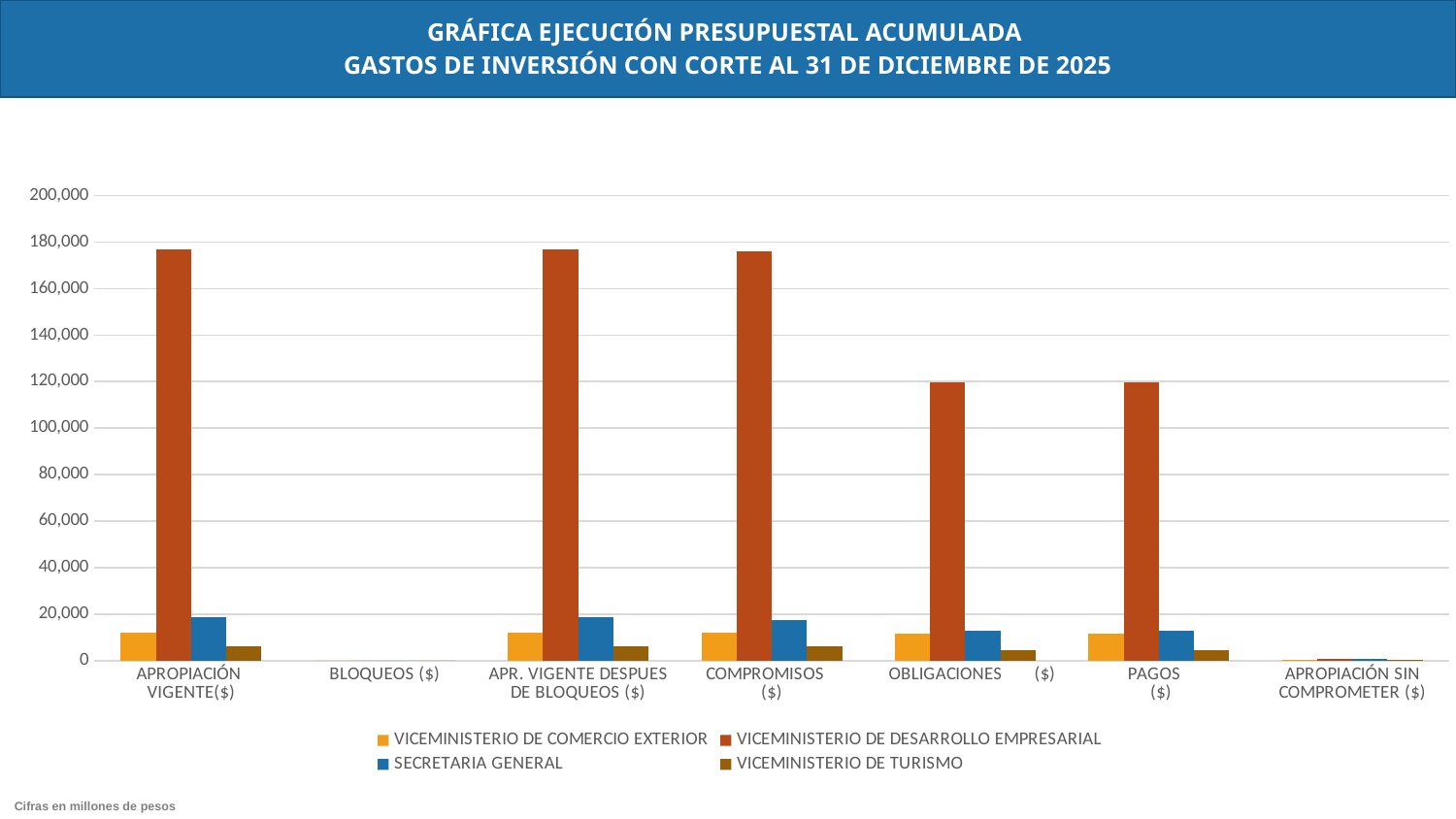
For VICEMINISTERIO DE DESARROLLO EMPRESARIAL, which is larger: the value in APROPIACIÓN VIGENTE($) or in OBLIGACIONES ($)? APROPIACIÓN VIGENTE($) What kind of chart is shown on the slide? bar chart How many series does the legend list? 4 Is the value for VICEMINISTERIO DE DESARROLLO EMPRESARIAL in APROPIACIÓN VIGENTE($) greater or less than 160,000? greater Is the value for VICEMINISTERIO DE DESARROLLO EMPRESARIAL in OBLIGACIONES ($) greater or less than 100,000? greater Which series has the highest value in the COMPROMISOS ($) category? VICEMINISTERIO DE DESARROLLO EMPRESARIAL Which series has the lowest value in the APROPIACIÓN VIGENTE($) category? VICEMINISTERIO DE TURISMO Is the value for VICEMINISTERIO DE DESARROLLO EMPRESARIAL in PAGOS ($) greater or less than 140,000? less According to the note at the bottom of the slide, in what units are the figures expressed? Cifras en millones de pesos How many categories are shown along the x axis? 7 In the PAGOS ($) category, which is larger: SECRETARIA GENERAL or VICEMINISTERIO DE TURISMO? SECRETARIA GENERAL